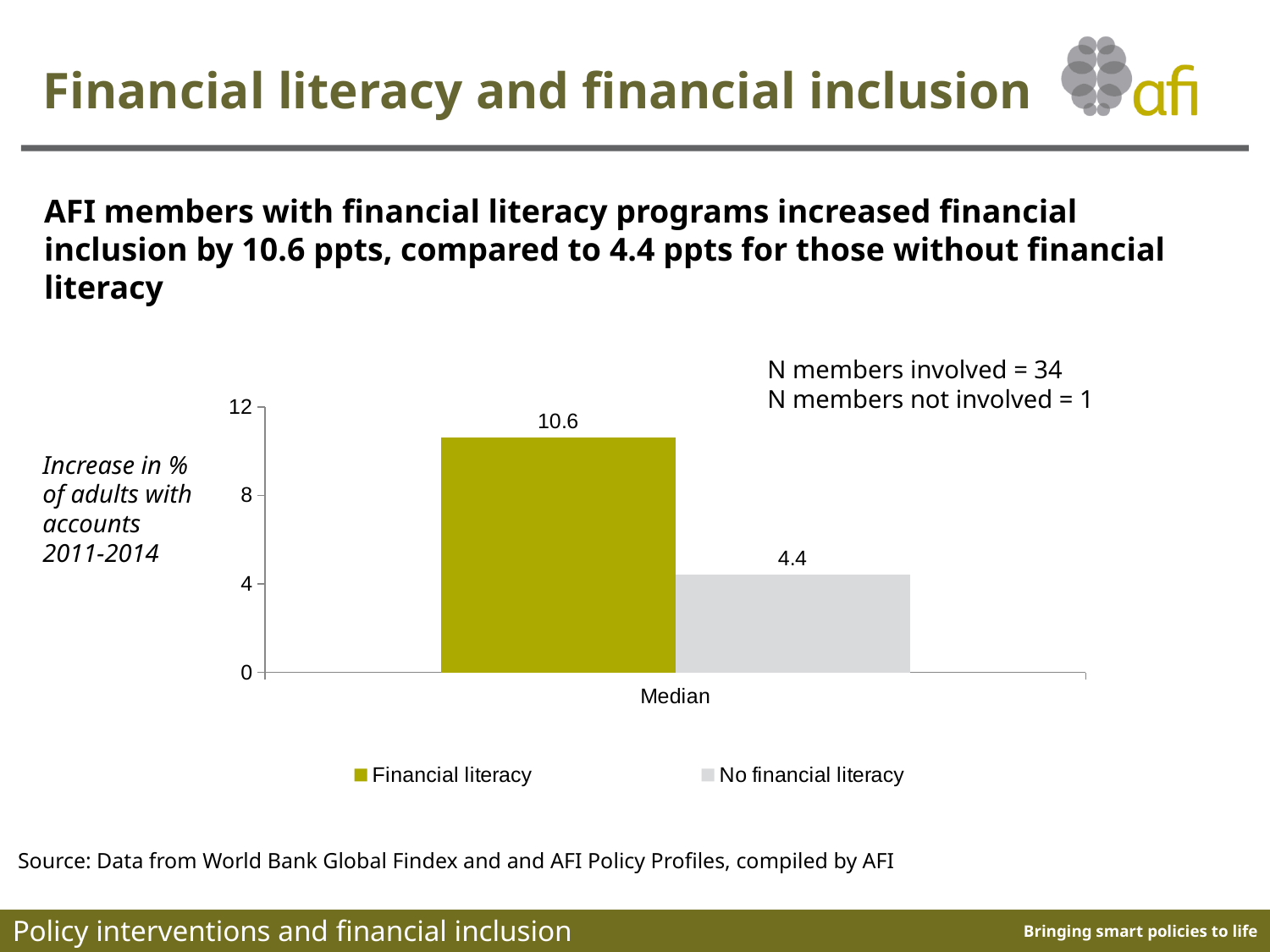
Which series has the lower value in the Median category? No financial literacy What is the difference between the Financial literacy and No financial literacy values? 6.2 What is the value for Financial literacy in the Median category? 10.6 What is the value for No financial literacy in the Median category? 4.4 How many categories are shown on the x axis? 1 How many series does the legend list? 2 What kind of chart is shown on the slide? Bar chart Is the value for Financial literacy greater or less than 8? greater Which series has the higher value in the Median category? Financial literacy What is the label of the category on the x axis? Median Is the value for No financial literacy greater or less than 8? less What is the maximum value shown on the y axis? 12